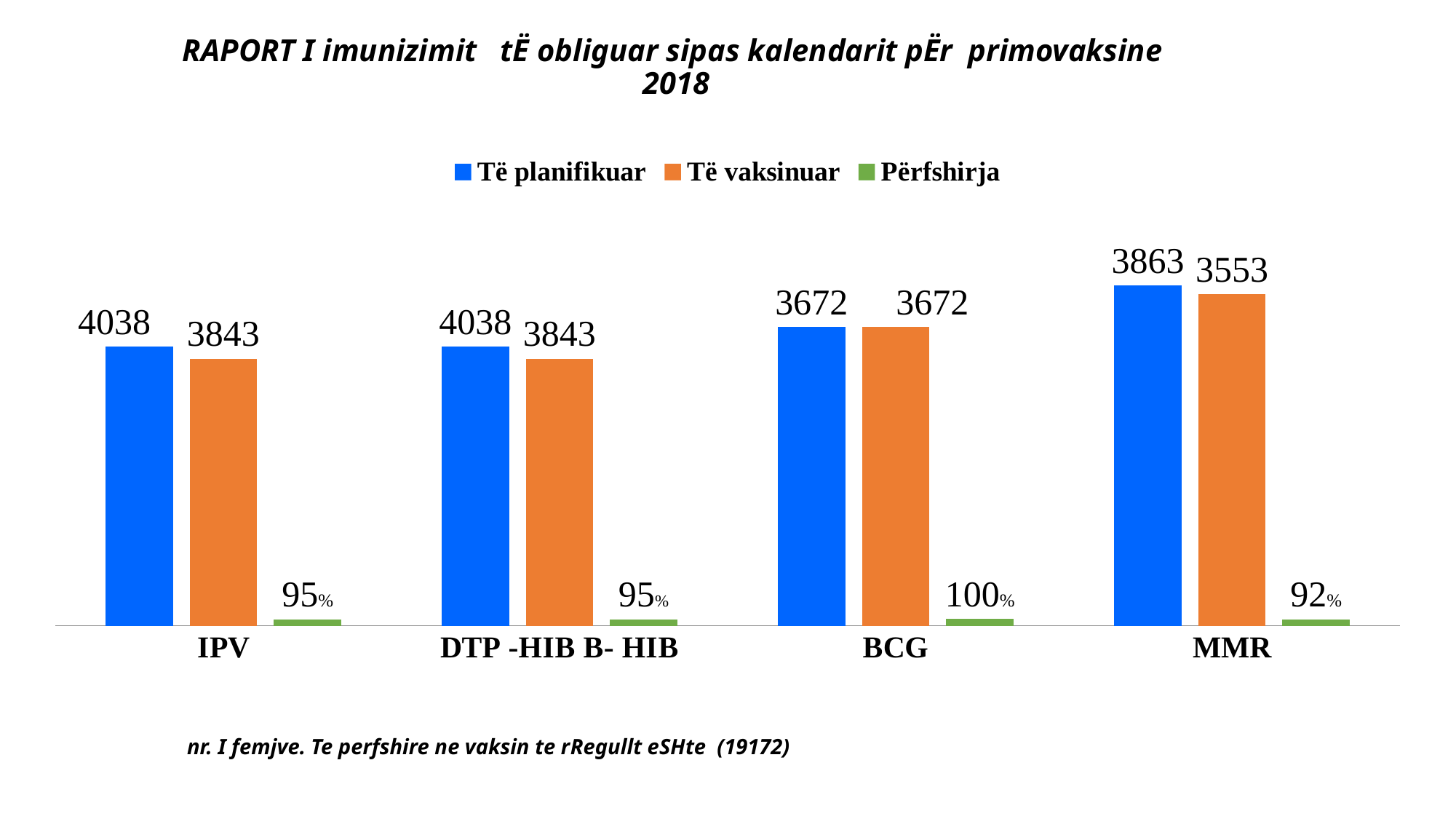
What is the difference between 'Të planifikuar' and 'Të vaksinuar' for MMR? 310 What is the difference between 'Të planifikuar' and 'Të vaksinuar' for IPV? 195 What is the 'Përfshirja' value for MMR? 92% How many categories are shown on the x axis? 4 What is the 'Të vaksinuar' value for MMR? 3553 How many series does the legend list? 3 Which category has the lowest 'Përfshirja' value? MMR What is the 'Të planifikuar' value for IPV? 4038 What kind of chart is shown on the slide? Bar chart What is the 'Përfshirja' value for BCG? 100%